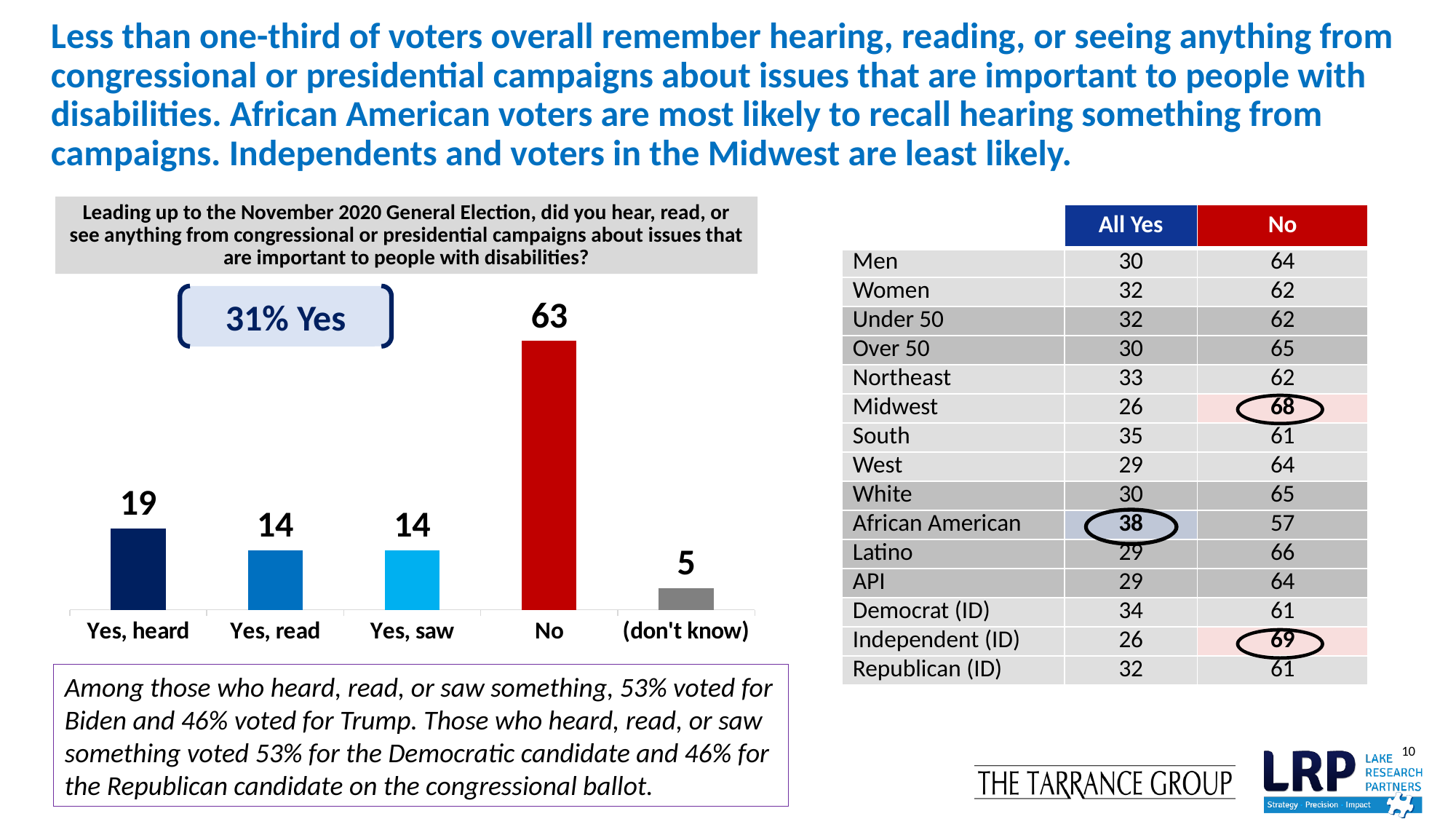
What is the value for the "No" bar in the chart? 63 What is the value for "(don't know)" in the chart? 5 Which category has the highest value in the chart? No What colour is the "No" bar in the chart? Red Which is larger, the value for "Yes, heard" or the value for "Yes, read"? Yes, heard What is the difference between the "No" bar and the "Yes, heard" bar? 44 What kind of chart is shown on the slide? Bar chart What is the total of the "Yes, read" and "Yes, saw" bars? 28 What is the value for "Yes, heard" in the chart? 19 Which category has the lowest value in the chart? (don't know) How many categories are shown in the bar chart? 5 What percentage is shown in the rounded box above the chart? 31% Yes